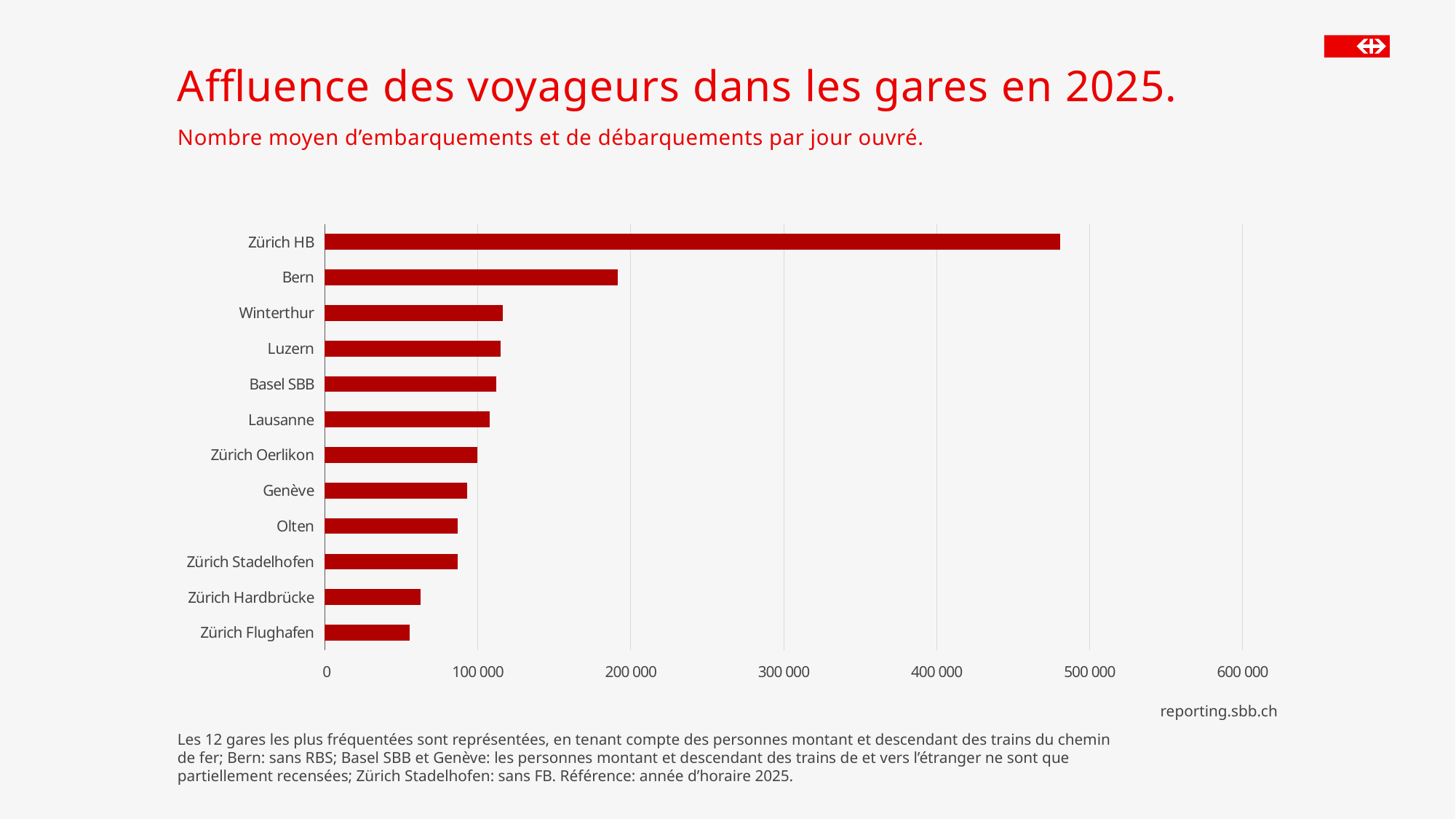
Is the value for Zürich HB greater or less than 400 000? greater Which station has the highest average number of boardings and alightings per working day? Zürich HB What is the title of the slide? Affluence des voyageurs dans les gares en 2025. Is the value for Bern greater or less than 200 000? less How many stations are shown in the chart? 12 Which has a larger value, Zürich Hardbrücke or Zürich Flughafen? Zürich Hardbrücke Which station has the lowest value in the chart? Zürich Flughafen Which has a larger value, Bern or Winterthur? Bern Is the value for Zürich Flughafen greater or less than 100 000? less What kind of chart is shown on the slide? Bar chart